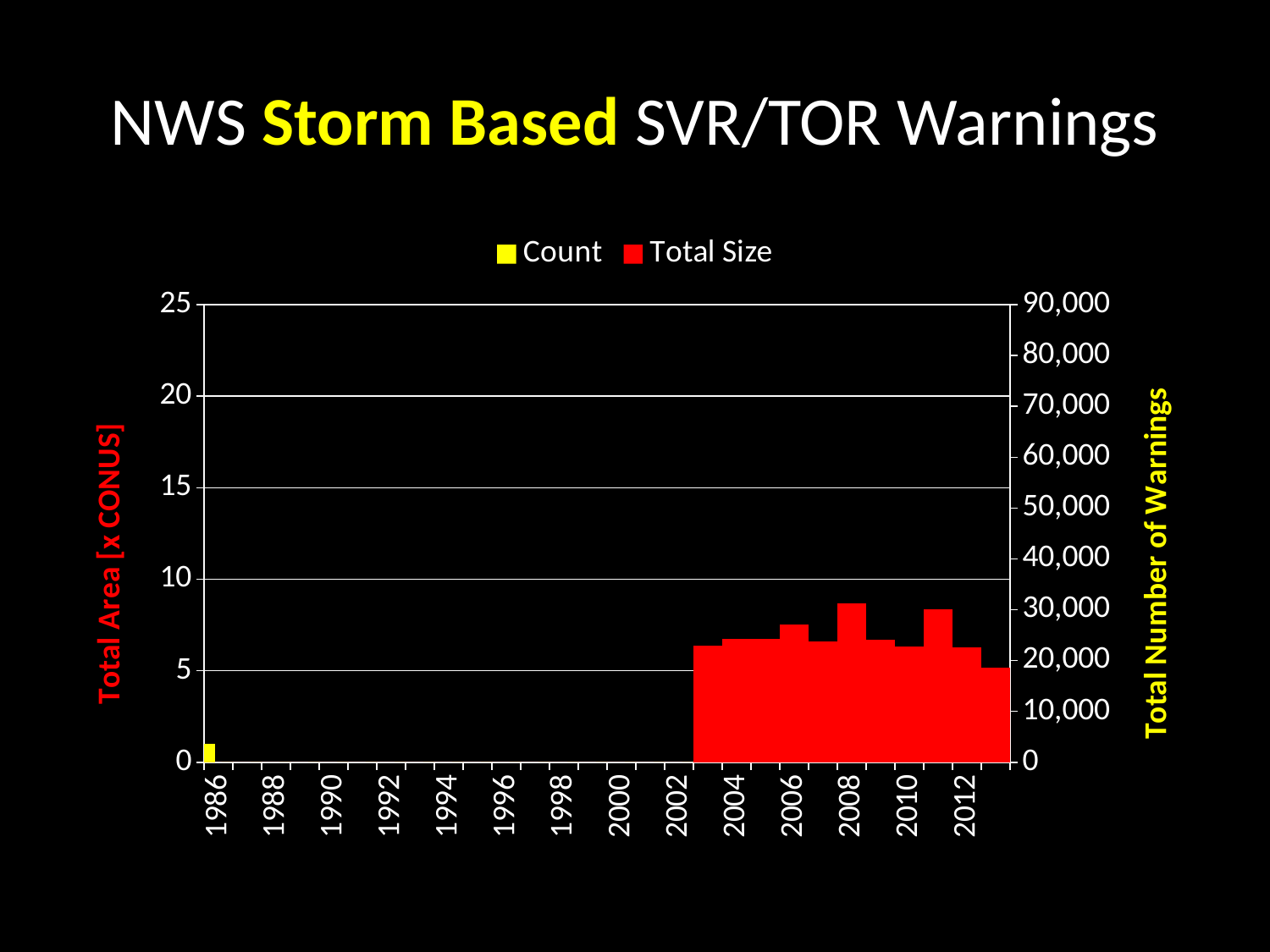
Which year has the lowest Total Size among the years from 2003 to 2013? 2013 How many series does the legend list? 2 Is the Count value for 1986 greater or less than 10,000 on the right axis? less Is the Total Size value for 2003 greater or less than 5 on the left axis? greater Is the Total Size value for 2013 greater or less than 10 on the left axis? less Do the Total Size values rise or fall from 2011 to 2013? fall Which is larger, the Total Size for 2008 or for 2013? 2008 Which is larger, the Total Size for 2006 or for 2004? 2006 What is the title of the left vertical axis? Total Area [x CONUS] What are the two series named in the legend? Count and Total Size What kind of chart is shown on the slide? bar chart